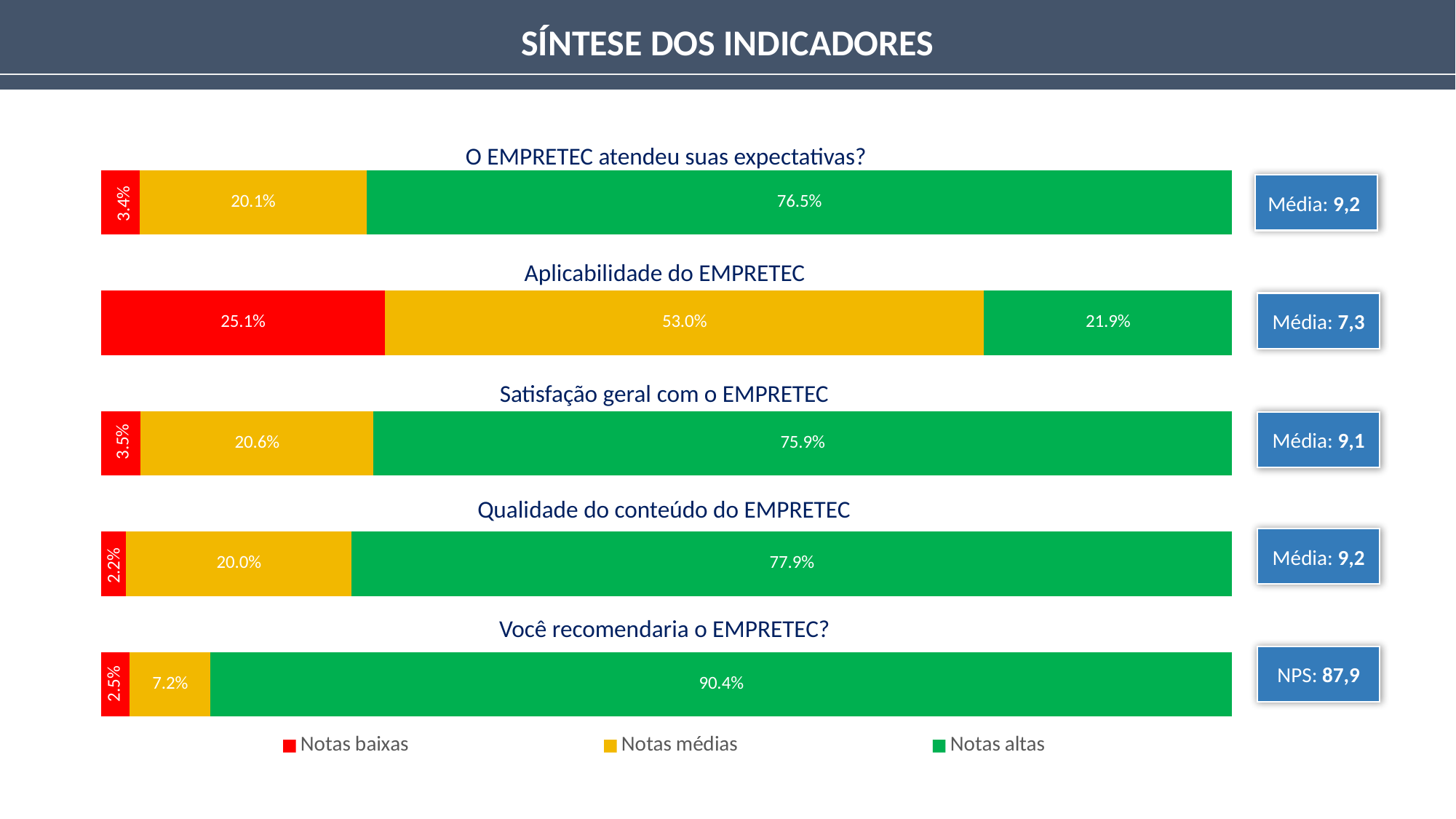
What kind of chart is used for "Satisfação geral com o EMPRETEC"? Stacked bar chart What colour represents Notas baixas in the legend? Red In the chart titled "Satisfação geral com o EMPRETEC", what is the value for Notas médias? 20.6% In the chart titled "Aplicabilidade do EMPRETEC", what is the difference between Notas médias and Notas altas? 31.1% Is the Notas altas value larger in the chart "Você recomendaria o EMPRETEC?" or in the chart "Aplicabilidade do EMPRETEC"? Você recomendaria o EMPRETEC? In the chart titled "Aplicabilidade do EMPRETEC", what is the value for Notas baixas? 25.1% In the chart titled "Qualidade do conteúdo do EMPRETEC", which segment is the smallest? Notas baixas In the chart titled "Você recomendaria o EMPRETEC?", what is the value for Notas altas? 90.4% In the chart titled "Aplicabilidade do EMPRETEC", which segment is the largest? Notas médias In the chart titled "Qualidade do conteúdo do EMPRETEC", what is the difference between Notas altas and Notas médias? 57.9% In the chart titled "O EMPRETEC atendeu suas expectativas?", what is the value for Notas altas? 76.5% How many series does the legend at the bottom of the slide list? 3